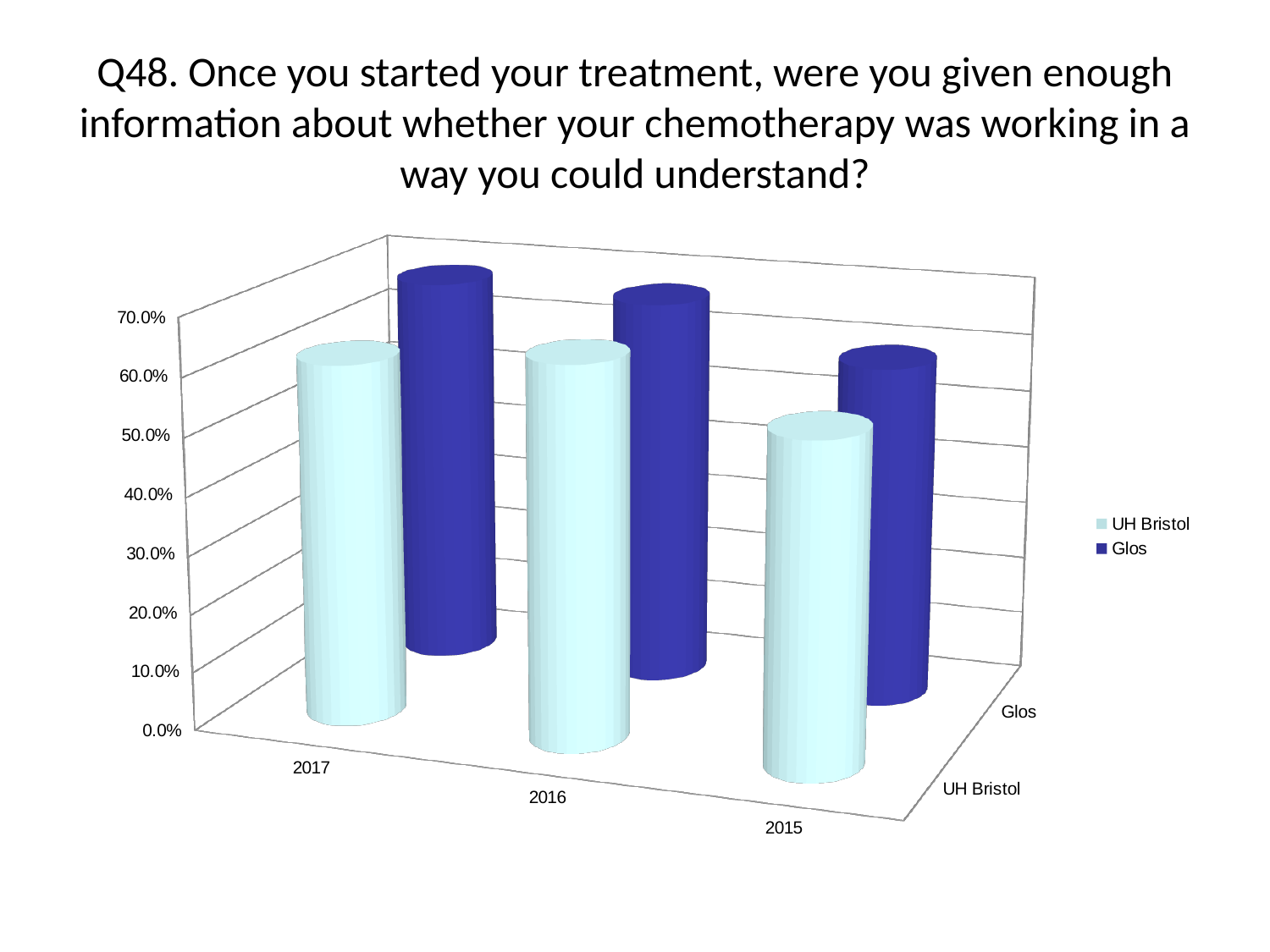
Which years are shown on the x axis? 2017, 2016, 2015 Which series are listed in the legend? UH Bristol and Glos For the Glos series, which year has the highest value? 2017 For the Glos series, which year has the lowest value? 2015 What kind of chart is shown on the slide? bar chart For the UH Bristol series, which year has the lowest value? 2015 How many series does the legend list? 2 Is the UH Bristol value for 2016 larger or smaller than the UH Bristol value for 2015? larger Is the value for UH Bristol in 2015 greater or less than 30.0%? greater Is the Glos value for 2017 larger or smaller than the Glos value for 2015? larger How many year categories are shown on the x axis? 3 Do the Glos values rise or fall moving along the x axis from 2017 to 2015? fall